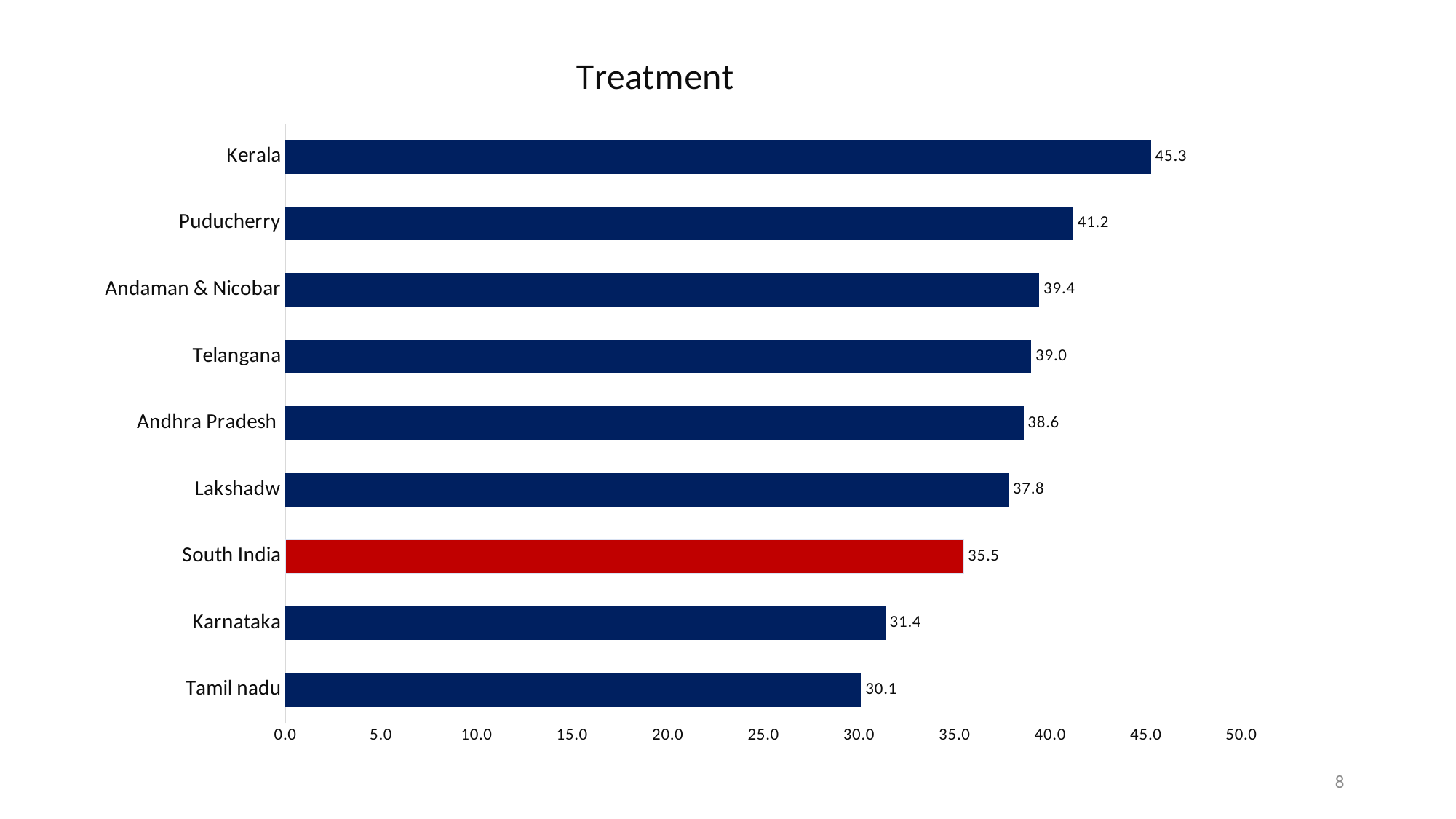
Which is larger, the value for Karnataka or the value for Lakshadw? Lakshadw Which category's bar is coloured red? South India What is the value for South India? 35.5 What is the value for Kerala? 45.3 What is the value for Tamil nadu? 30.1 What is the difference between the values for Kerala and Puducherry? 4.1 What kind of chart is shown? bar chart Which category has the highest value? Kerala Which category has the lowest value? Tamil nadu What is the title of the chart? Treatment How many categories are shown in the chart? 9 Is the value for Andaman & Nicobar greater or less than 35.0? greater